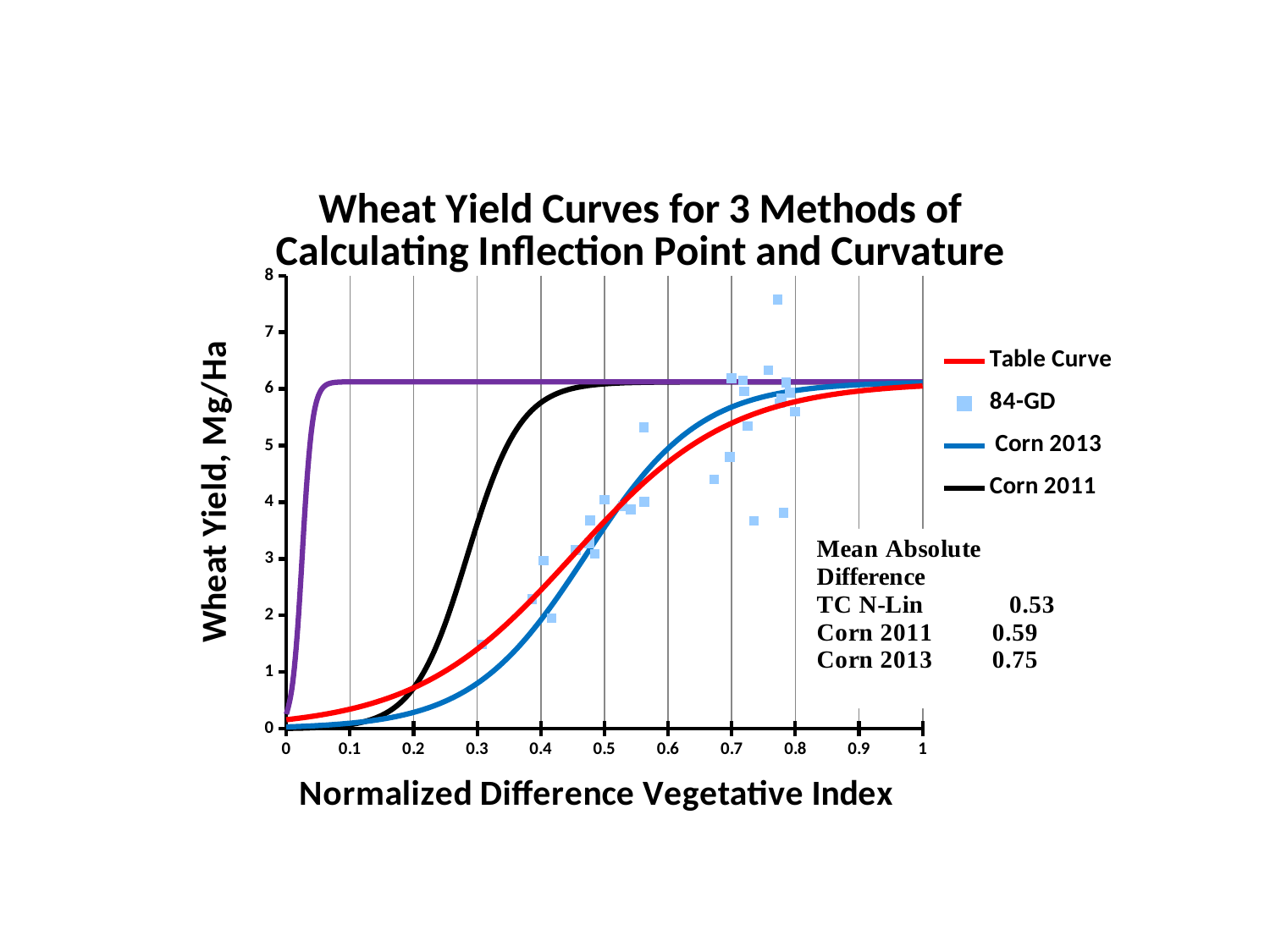
According to the text on the chart, what is the Mean Absolute Difference for Corn 2013? 0.75 At an NDVI of 0.2, which curve is higher: Table Curve or Corn 2013? Table Curve Is the value of the Corn 2011 curve at an NDVI of 0.3 greater or less than 3? greater Do the fitted curves rise or fall as the Normalized Difference Vegetative Index increases? rise What kind of chart is shown on the slide? line chart At an NDVI of 0.3, which curve is higher: Corn 2011 or Corn 2013? Corn 2011 What is the label of the y axis? Wheat Yield, Mg/Ha Is the value of the Corn 2011 curve at an NDVI of 0.1 greater or less than 1? less What is the title of the chart? Wheat Yield Curves for 3 Methods of Calculating Inflection Point and Curvature How many series does the legend list? 4 Is the value of the Corn 2013 curve at an NDVI of 0.2 greater or less than 1? less